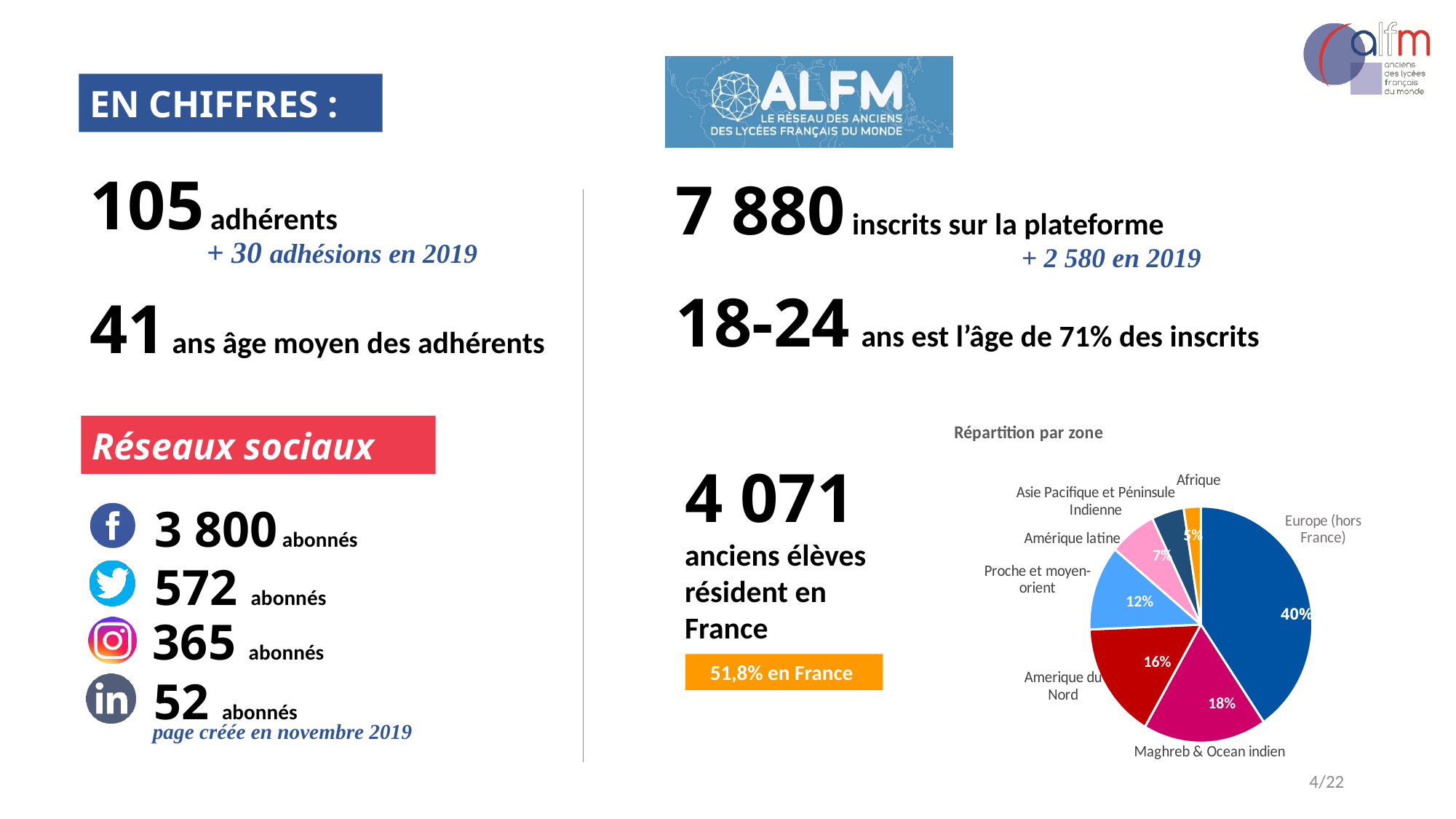
Which zone has the largest slice in the 'Répartition par zone' pie chart? Europe (hors France) In the 'Répartition par zone' pie chart, what is the value for Maghreb & Ocean indien? 18% How many zones are shown in the 'Répartition par zone' pie chart? 7 In the 'Répartition par zone' pie chart, what is the value for Amérique latine? 7% What kind of chart is shown under the title 'Répartition par zone'? pie chart In the 'Répartition par zone' pie chart, what is the value for Proche et moyen-orient? 12% Which zone has the smallest slice in the 'Répartition par zone' pie chart? Afrique In the 'Répartition par zone' pie chart, how many percentage points larger is Europe (hors France) than Maghreb & Ocean indien? 22 In the 'Répartition par zone' pie chart, which is larger: Amerique du Nord or Proche et moyen-orient? Amerique du Nord In the 'Répartition par zone' pie chart, what is the value for Amerique du Nord? 16% What is the title of the pie chart on the slide? Répartition par zone In the 'Répartition par zone' pie chart, what share does Europe (hors France) have? 40%